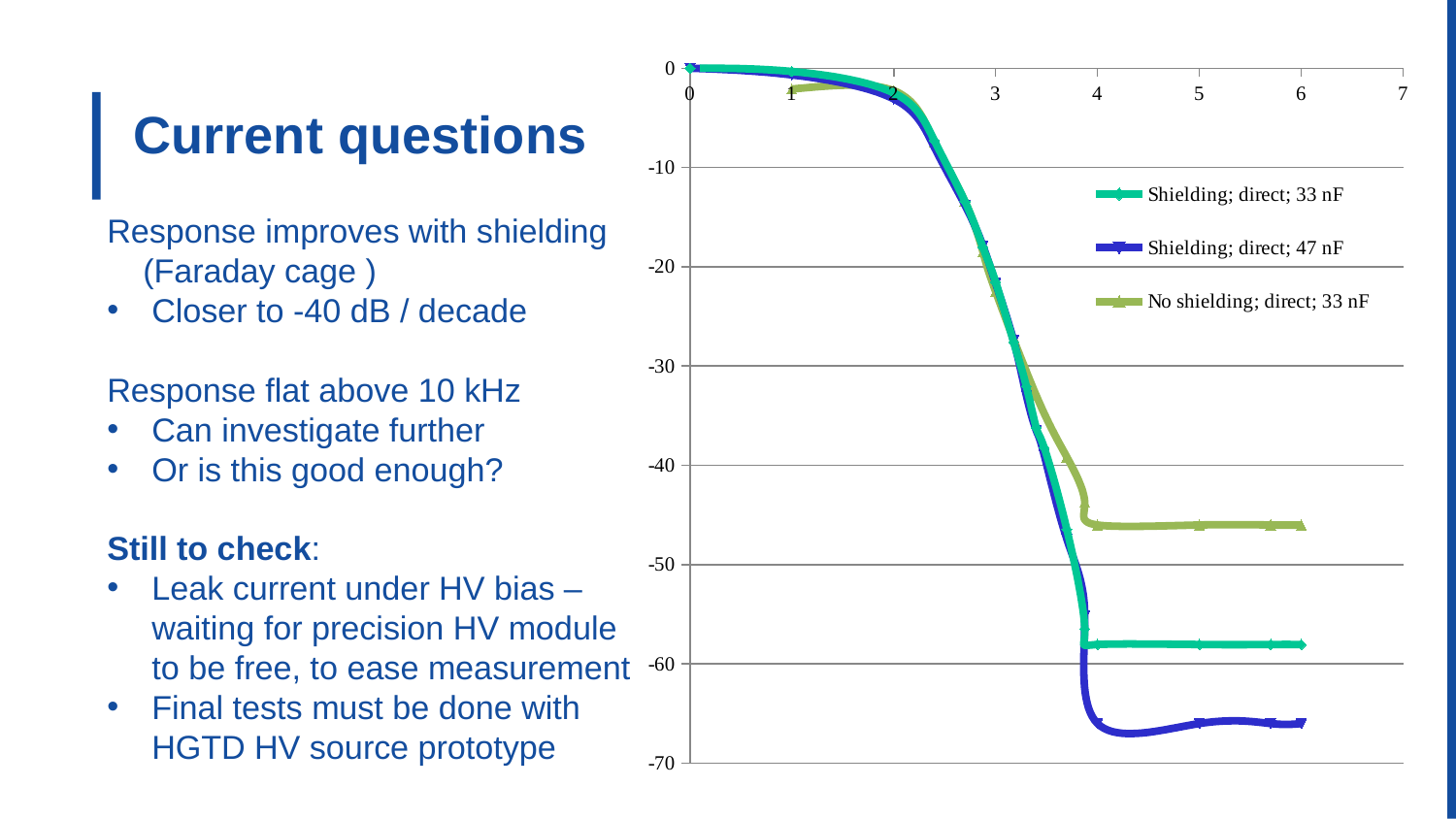
Which series in the chart is drawn in dark blue? Shielding; direct; 47 nF Do the values of the 'Shielding; direct; 47 nF' series rise or fall as the x axis goes from 0 to 4? fall How many series does the chart legend list? 3 What kind of chart is shown on the slide? line chart At x = 5, which series has the larger value: 'Shielding; direct; 33 nF' or 'Shielding; direct; 47 nF'? Shielding; direct; 33 nF Is the value of the 'No shielding; direct; 33 nF' series at x = 1 greater or less than -10? greater Is the value of the 'Shielding; direct; 47 nF' series at x = 5 greater or less than -60? less At x = 5, which series has the highest value on the chart? No shielding; direct; 33 nF What are the three series named in the chart legend? Shielding; direct; 33 nF, Shielding; direct; 47 nF, No shielding; direct; 33 nF Is the value of the 'No shielding; direct; 33 nF' series at x = 5 greater or less than -40? less At x = 5, which series has the lowest value on the chart? Shielding; direct; 47 nF